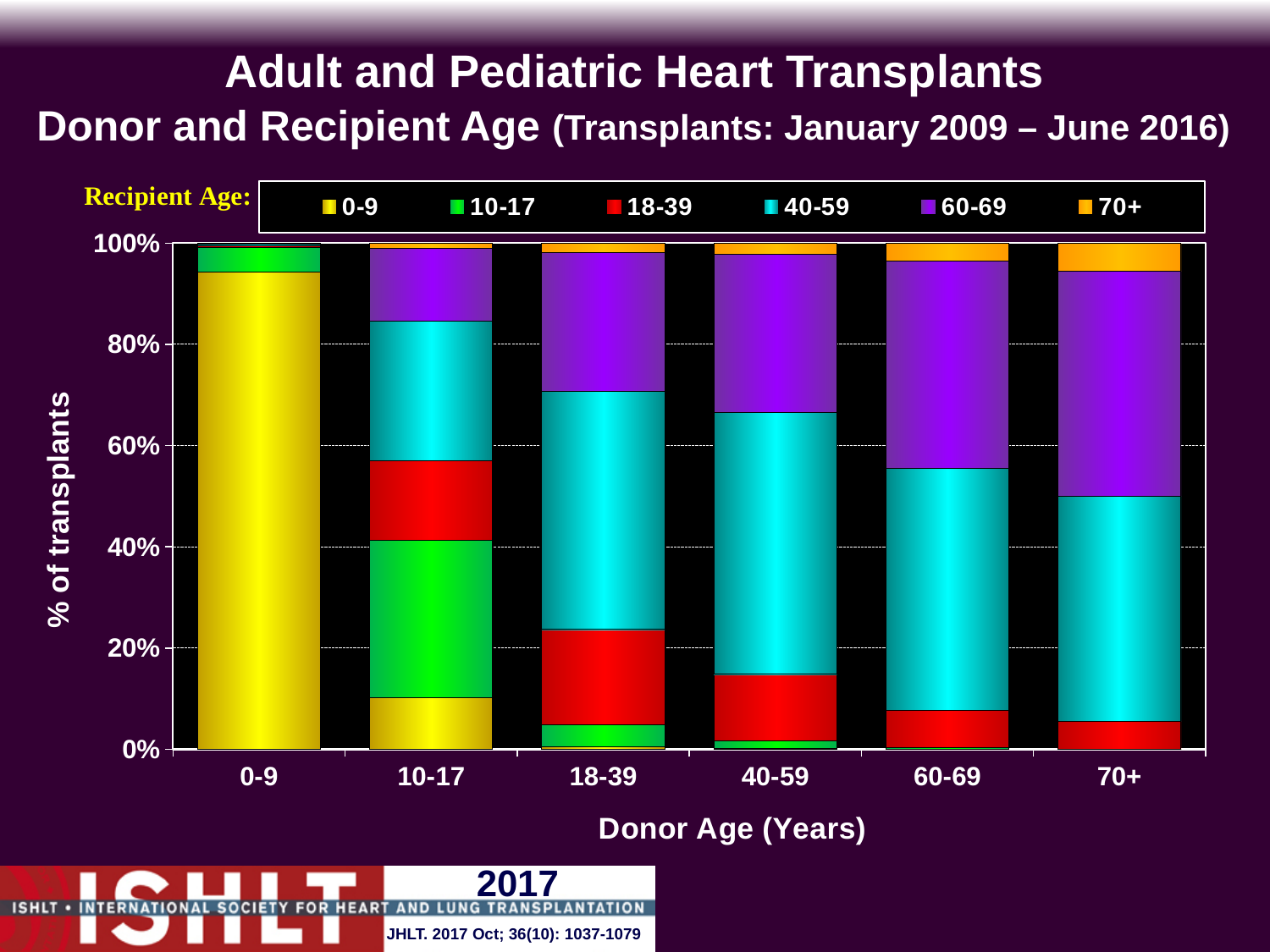
Which donor age group has the largest share of 18-39 recipients? 18-39 Is the share of 18-39 recipients for donor age 40-59 greater or less than 20%? less How many donor age categories are shown on the x axis? 6 Is the share of 0-9 recipients for donor age 0-9 greater or less than 80%? greater What kind of chart is shown on the slide? Stacked bar chart Which donor age group has the largest share of 0-9 recipients? 0-9 Is the share of 0-9 recipients for donor age 10-17 greater or less than 20%? less What is the total height of the stacked bar for donor age 0-9? 100% Does the share of 60-69 recipients rise or fall as donor age increases along the x axis? rises How many recipient age groups does the legend list? 6 What is the label of the y axis? % of transplants